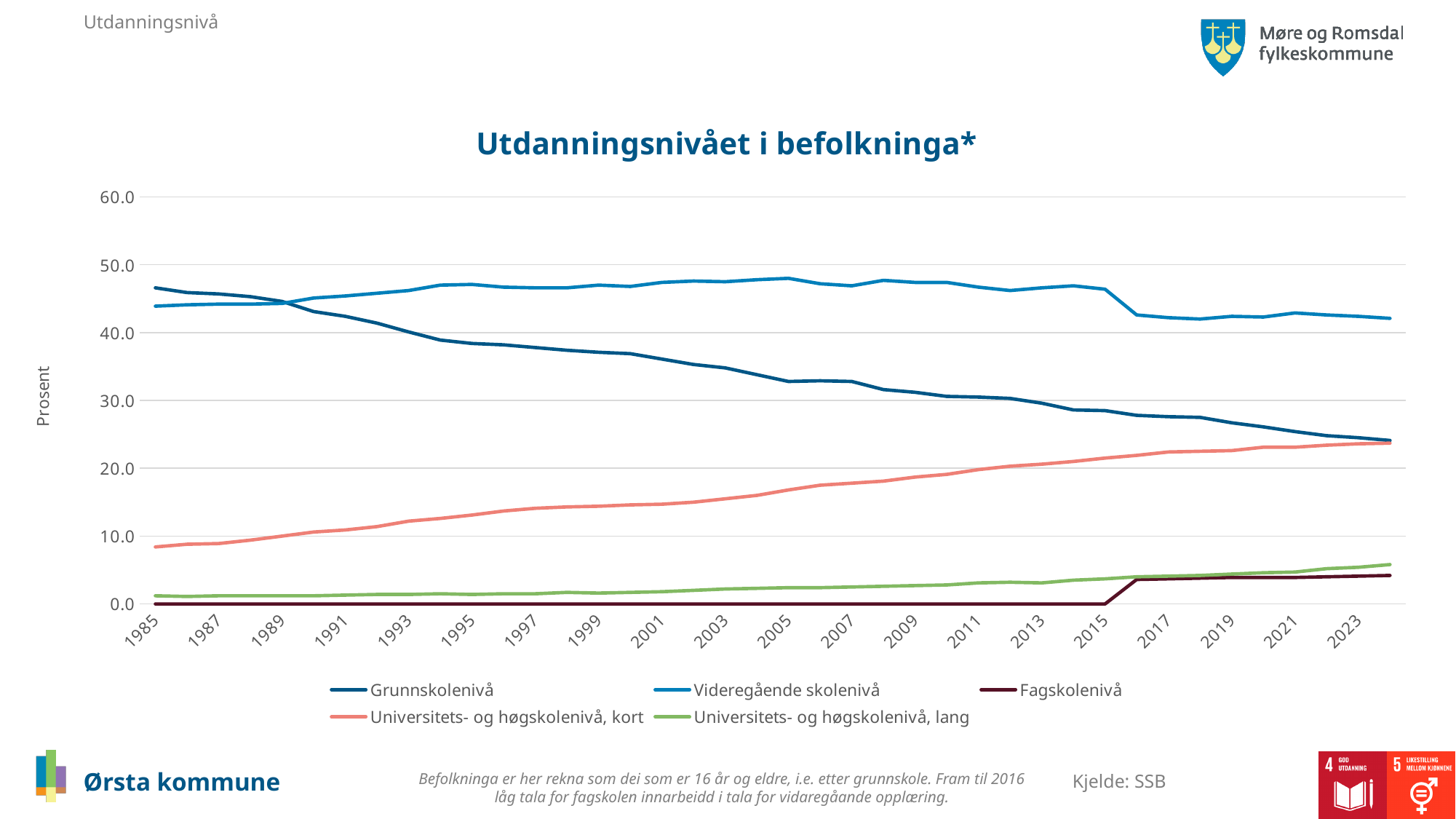
Is the value for Universitets- og høgskolenivå, kort in 1985 greater or less than 10? less Which series has the lowest value in 2010? Fagskolenivå What kind of chart is shown on the slide? line chart Is the value for Grunnskolenivå in 2023 greater or less than 30? less Which series has the highest value in 2005? Videregående skolenivå What is the label on the vertical axis? Prosent What is the title of the chart? Utdanningsnivået i befolkninga* How many series does the legend list? 5 Does the Grunnskolenivå line rise or fall from 1985 to 2023? fall Does the Universitets- og høgskolenivå, kort line rise or fall from 1985 to 2023? rise Is the value for Grunnskolenivå in 1985 greater or less than 40? greater